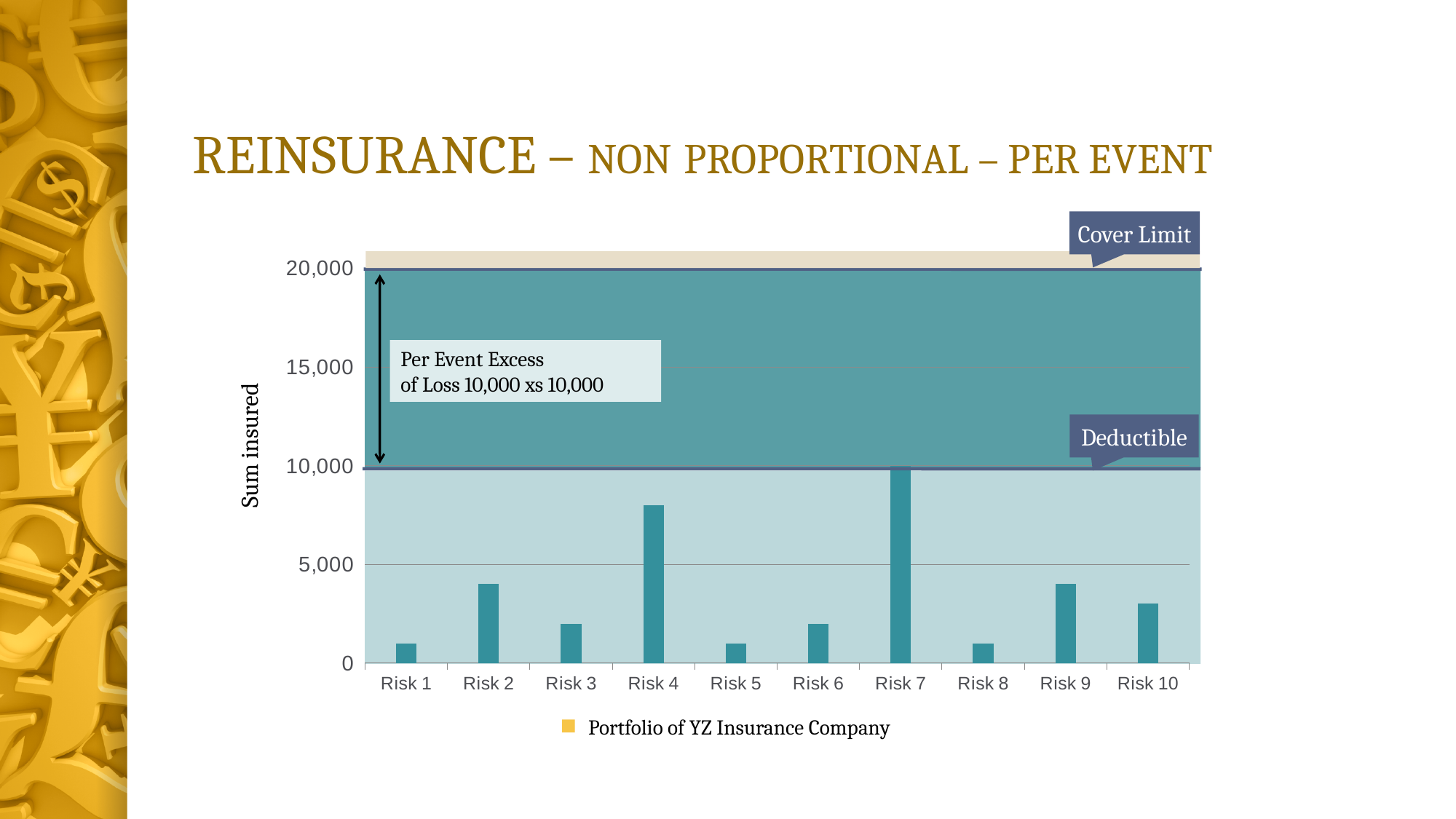
How many risks are plotted on the x axis? 10 Is the value for Risk 1 greater or less than 5,000? less Is the value for Risk 2 greater or less than 5,000? less Is the value for Risk 4 greater or less than 5,000? greater What is the title of the y axis? Sum insured What kind of chart is shown on the slide? bar chart Which is larger, the value for Risk 10 or the value for Risk 7? Risk 7 Which risk has the highest sum insured? Risk 7 Which is larger, the value for Risk 4 or the value for Risk 2? Risk 4 How many series does the legend list? 1 What is the legend entry for the plotted series? Portfolio of YZ Insurance Company What is the sum insured for Risk 7? 10,000